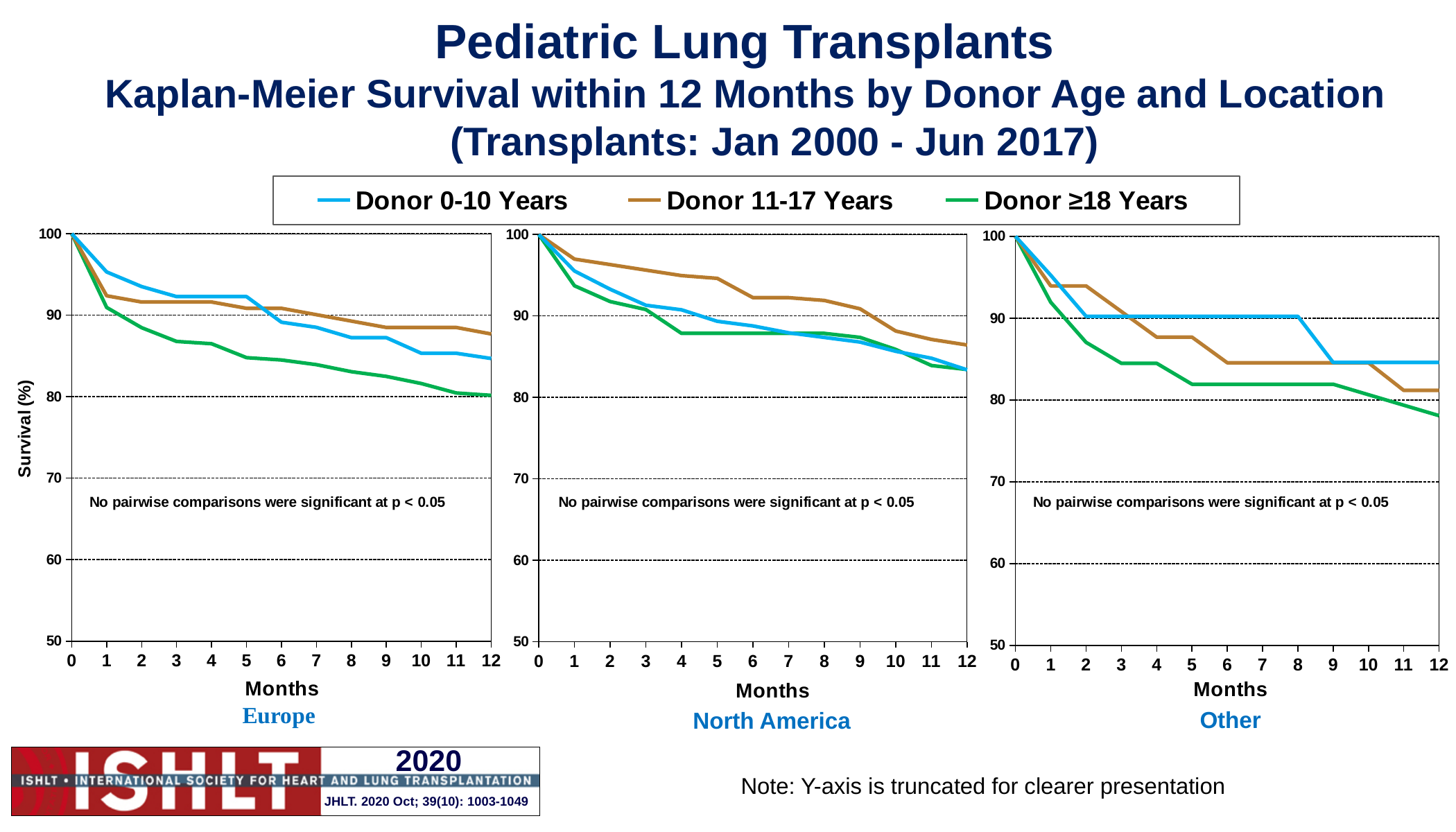
In the Europe chart, is the value for Donor ≥18 Years at month 6 greater or less than 90? less What kind of chart is the Europe chart? line chart In the Europe chart, do the survival values rise or fall as months increase? fall In the Europe chart, what is the survival value for Donor 0-10 Years at month 0? 100 How many series does the legend list? 3 How many charts are shown on the slide? 3 In the Other chart, at month 12, which is higher: Donor 0-10 Years or Donor ≥18 Years? Donor 0-10 Years In the Europe chart, is the value for Donor 0-10 Years at month 12 greater or less than 90? less In the Other chart, is the value for Donor ≥18 Years at month 12 greater or less than 80? less Which colour represents Donor 11-17 Years in the legend? brown In the Europe chart, which series has the lowest survival at month 12? Donor ≥18 Years